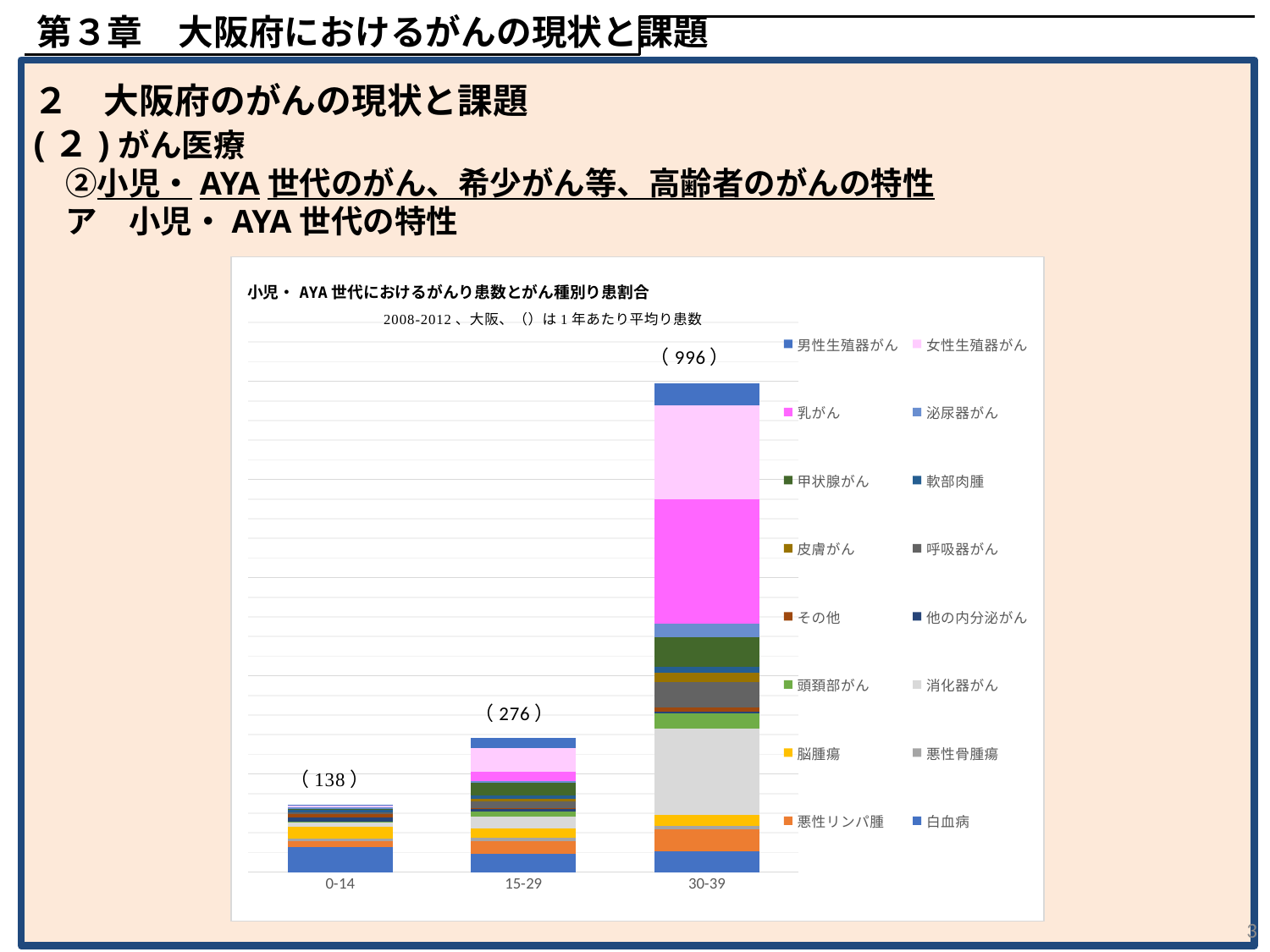
What is the title of the chart? 小児・AYA世代におけるがんり患数とがん種別り患割合 What is the total number of patients shown for the 30-39 age group? 996 What is the difference between the totals for the 30-39 and 15-29 age groups? 720 What is the difference between the totals for the 15-29 and 0-14 age groups? 138 How many age-group categories are shown on the x axis? 3 What kind of chart is shown on the slide? bar chart Which age group has the lowest total number of patients? 0-14 What is the total number of patients shown for the 0-14 age group? 138 How many series does the legend list? 16 What is the total number of patients shown for the 15-29 age group? 276 Which age group has the highest total number of patients? 30-39 Do the bar totals rise or fall from the 0-14 group to the 30-39 group? rise